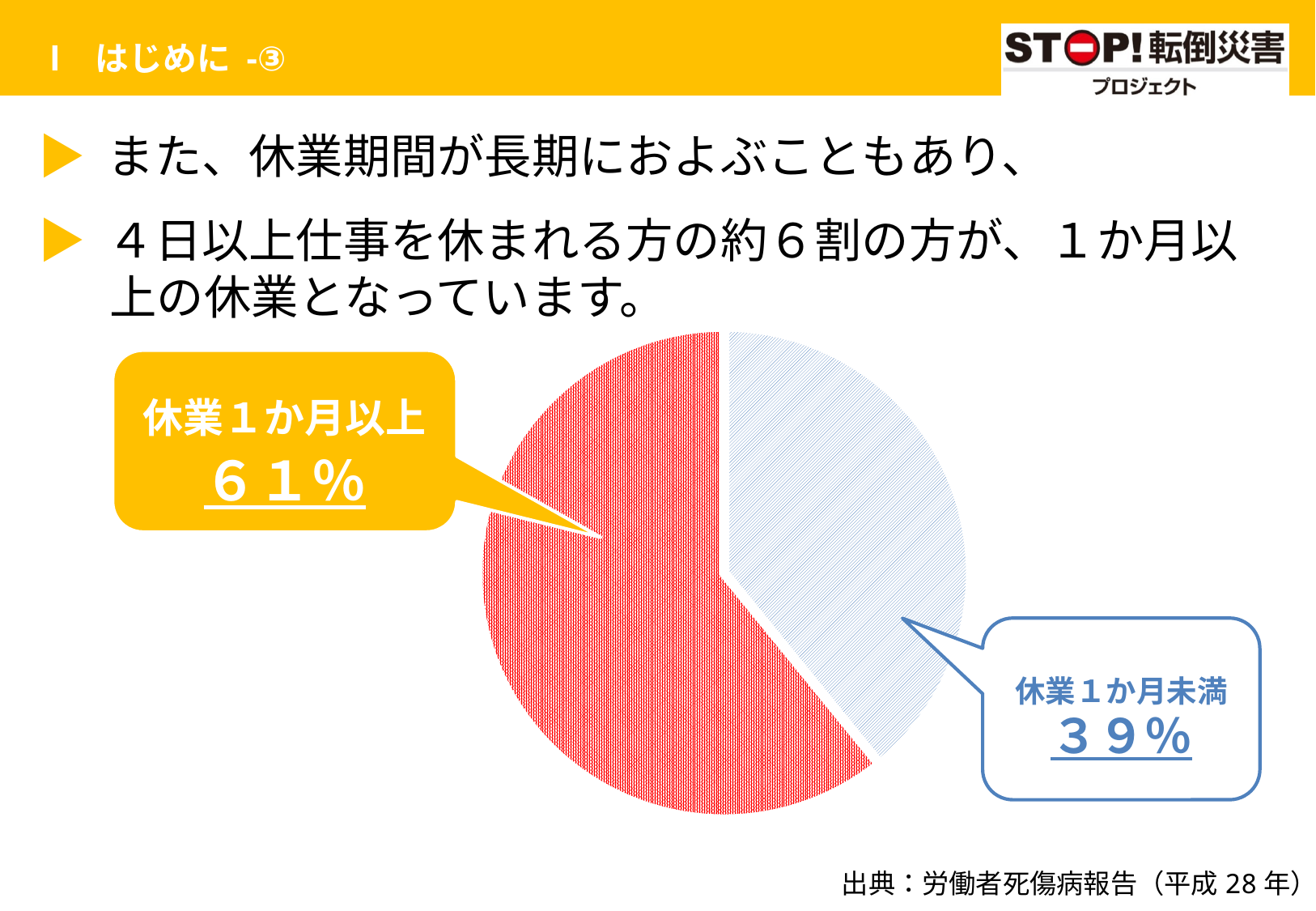
What colour is the slice for 休業１か月以上? red How many slices does the pie chart have? 2 What share of the pie does 休業１か月未満 represent? 39% What is the difference in percentage points between 休業１か月以上 and 休業１か月未満? 22 What colour is the slice for 休業１か月未満? blue What share of the pie does 休業１か月以上 represent? 61% Which is larger, the share for 休業１か月以上 or the share for 休業１か月未満? 休業１か月以上 Which slice of the pie is the largest? 休業１か月以上 What kind of chart is shown on the slide? pie chart What is the total of the two slices shown in the pie chart? 100% Which slice of the pie is the smallest? 休業１か月未満